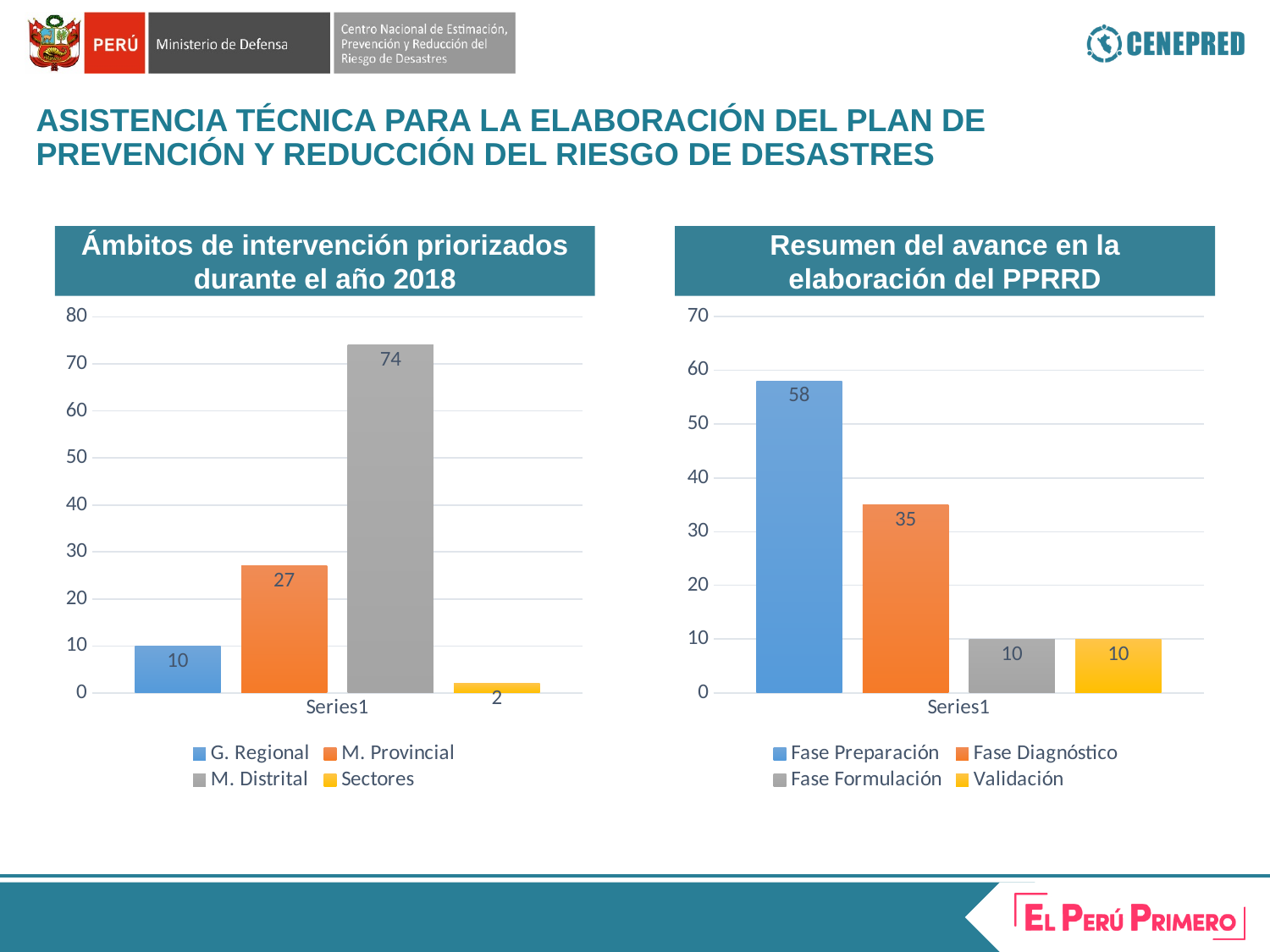
In the chart 'Resumen del avance en la elaboración del PPRRD', which series has the highest value? Fase Preparación In the chart 'Resumen del avance en la elaboración del PPRRD', what is the difference between Fase Preparación and Fase Diagnóstico? 23 What kind of chart is 'Resumen del avance en la elaboración del PPRRD'? Bar chart In the chart 'Resumen del avance en la elaboración del PPRRD', what is the value for Validación? 10 In the chart 'Ámbitos de intervención priorizados durante el año 2018', what is the difference between M. Distrital and M. Provincial? 47 In the chart 'Ámbitos de intervención priorizados durante el año 2018', what is the value for G. Regional? 10 In the chart 'Resumen del avance en la elaboración del PPRRD', what colour is the bar for Fase Formulación? Grey In the chart 'Resumen del avance en la elaboración del PPRRD', what is the value for Fase Diagnóstico? 35 In the chart 'Ámbitos de intervención priorizados durante el año 2018', which series has the lowest value? Sectores In the chart 'Ámbitos de intervención priorizados durante el año 2018', which is larger, M. Provincial or G. Regional? M. Provincial In the chart 'Ámbitos de intervención priorizados durante el año 2018', how many series does the legend list? 4 In the chart 'Ámbitos de intervención priorizados durante el año 2018', what is the value for M. Distrital? 74